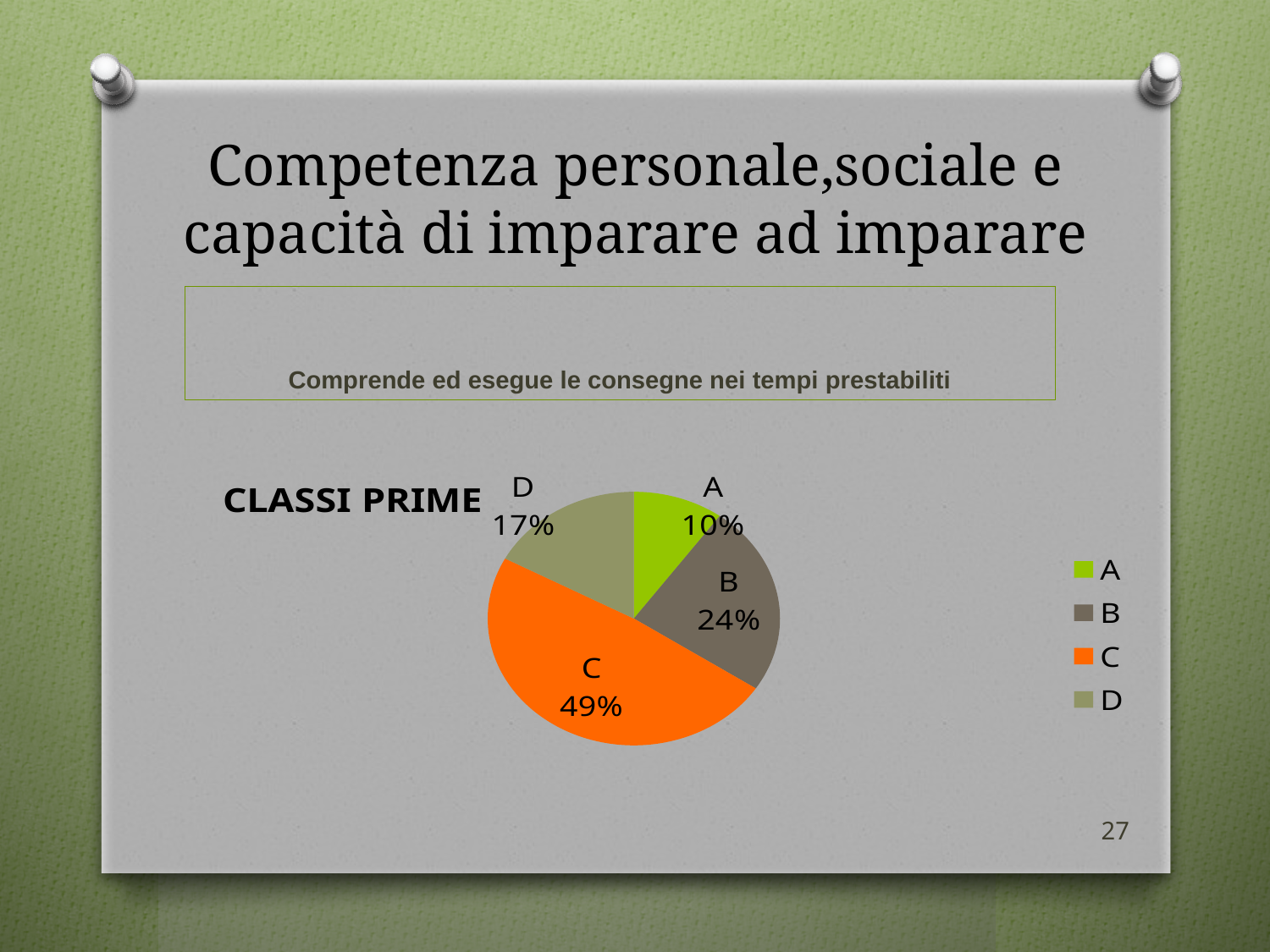
How many slices does the pie chart have? 4 How many entries does the legend list? 4 What label appears to the left of the pie chart? CLASSI PRIME Which slice is the smallest in the pie chart? A Which slice is the largest in the pie chart? C What share of the pie does slice A represent? 10% What share of the pie does slice C represent? 49% What kind of chart is shown on the slide? pie chart What is the difference in percentage points between slice C and slice B? 25 What share of the pie does slice D represent? 17% Which is larger, slice B or slice D? B